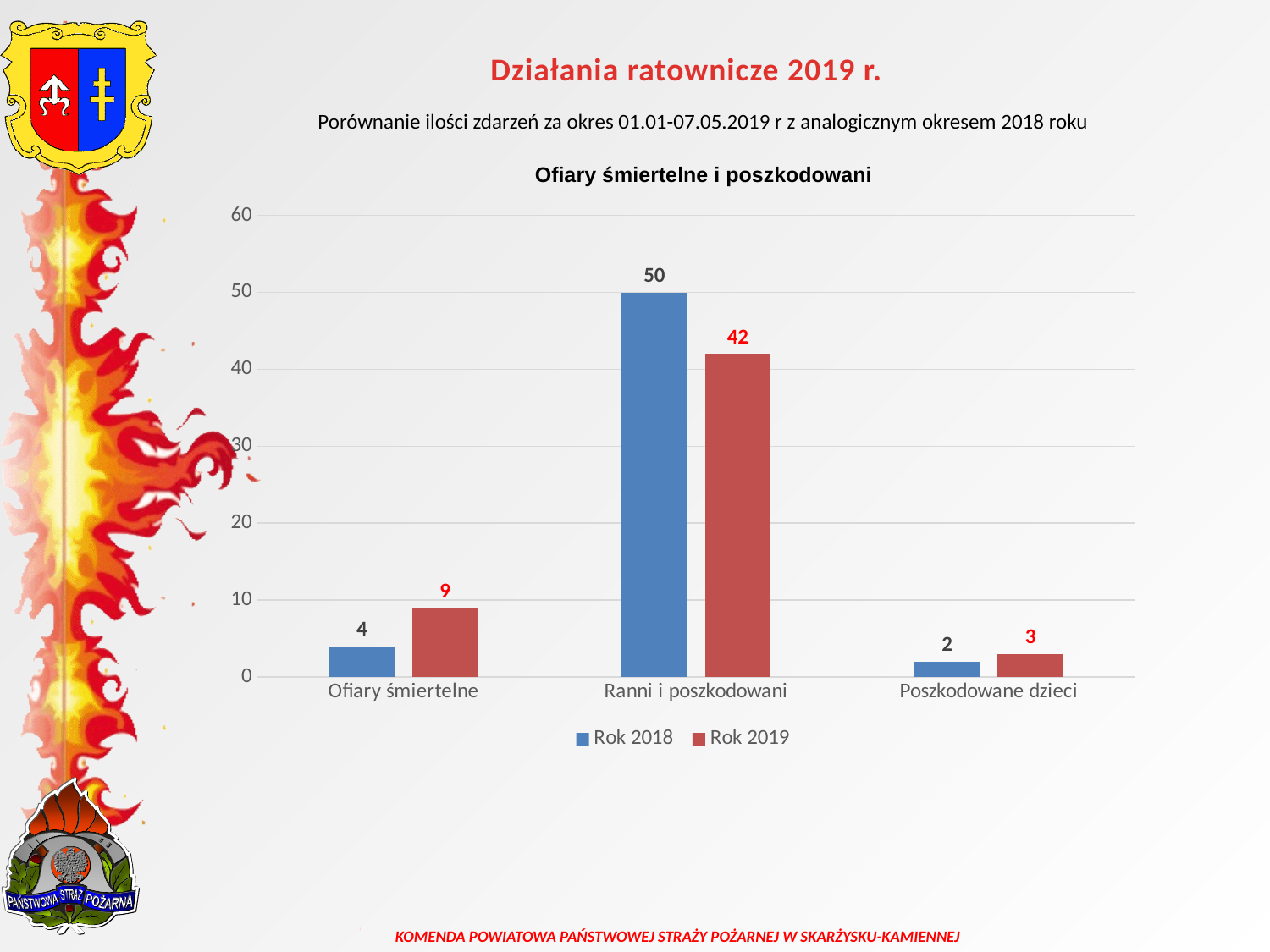
Which is larger for Ofiary śmiertelne: the Rok 2018 value or the Rok 2019 value? Rok 2019 Which category has the highest value for Rok 2019? Ranni i poszkodowani What is the difference between the Rok 2018 and Rok 2019 values for Ranni i poszkodowani? 8 What is the title of the chart? Ofiary śmiertelne i poszkodowani How many series does the legend list? 2 Is the Rok 2019 value for Ranni i poszkodowani greater or less than 40? greater How many categories are shown on the x axis? 3 What is the value for Rok 2018 in the Ranni i poszkodowani category? 50 Which category has the lowest value for Rok 2018? Poszkodowane dzieci What is the value for Rok 2019 in the Ofiary śmiertelne category? 9 What kind of chart is shown on the slide? bar chart What is the value for Rok 2019 in the Poszkodowane dzieci category? 3